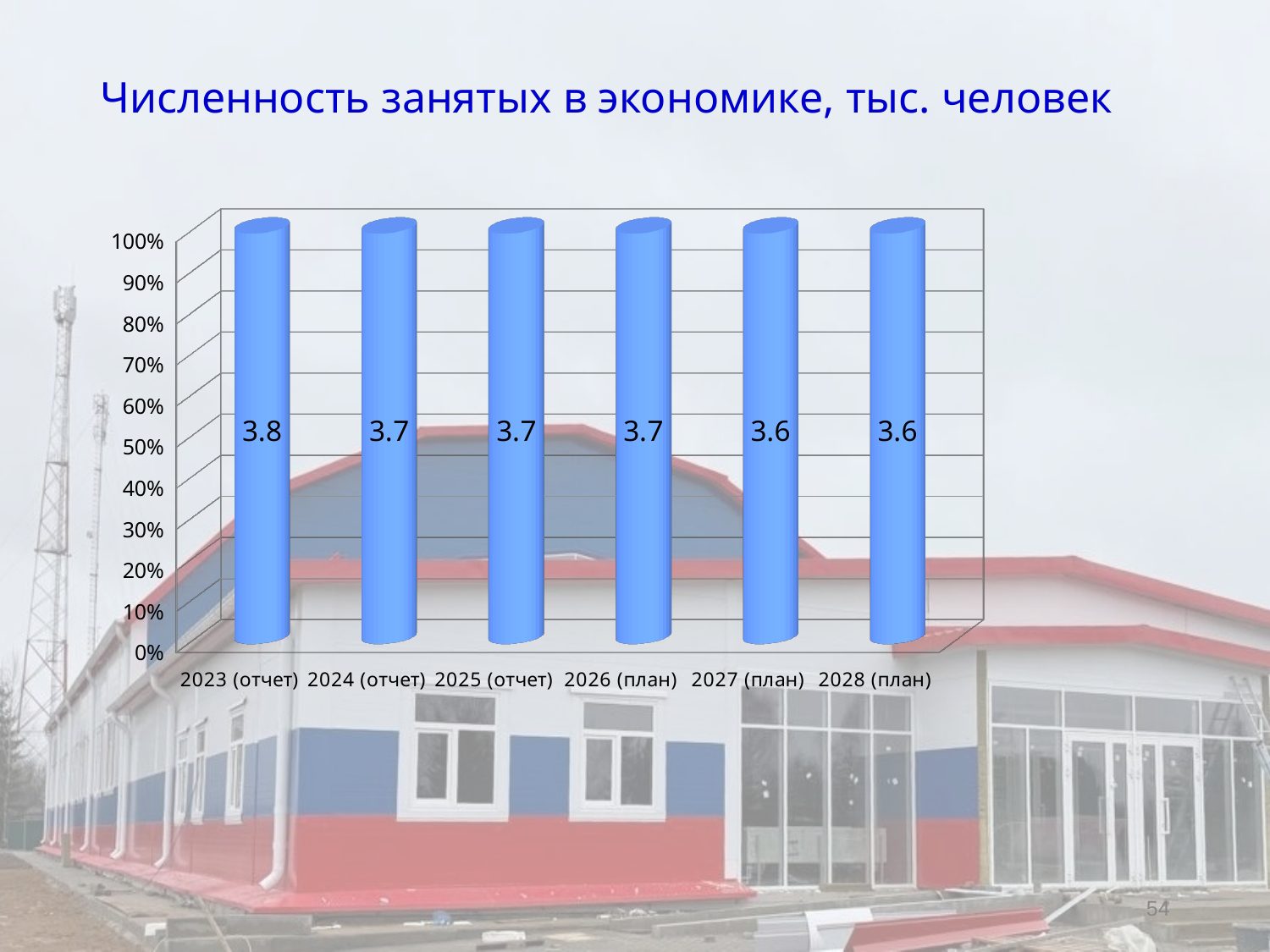
What is the value shown for 2027 (план)? 3.6 What is the value shown for 2028 (план)? 3.6 What kind of chart is shown on the slide? bar chart How many years are shown on the x axis? 6 What is the value shown for 2023 (отчет)? 3.8 What is the title of the chart? Численность занятых в экономике, тыс. человек Do the labelled values rise or fall from 2023 to 2028? fall What is the difference between the values for 2023 (отчет) and 2028 (план)? 0.2 Which year has the highest value? 2023 (отчет) What is the difference between the values for 2024 (отчет) and 2027 (план)? 0.1 What is the value shown for 2025 (отчет)? 3.7 Which is larger, the value for 2023 (отчет) or the value for 2024 (отчет)? 2023 (отчет)